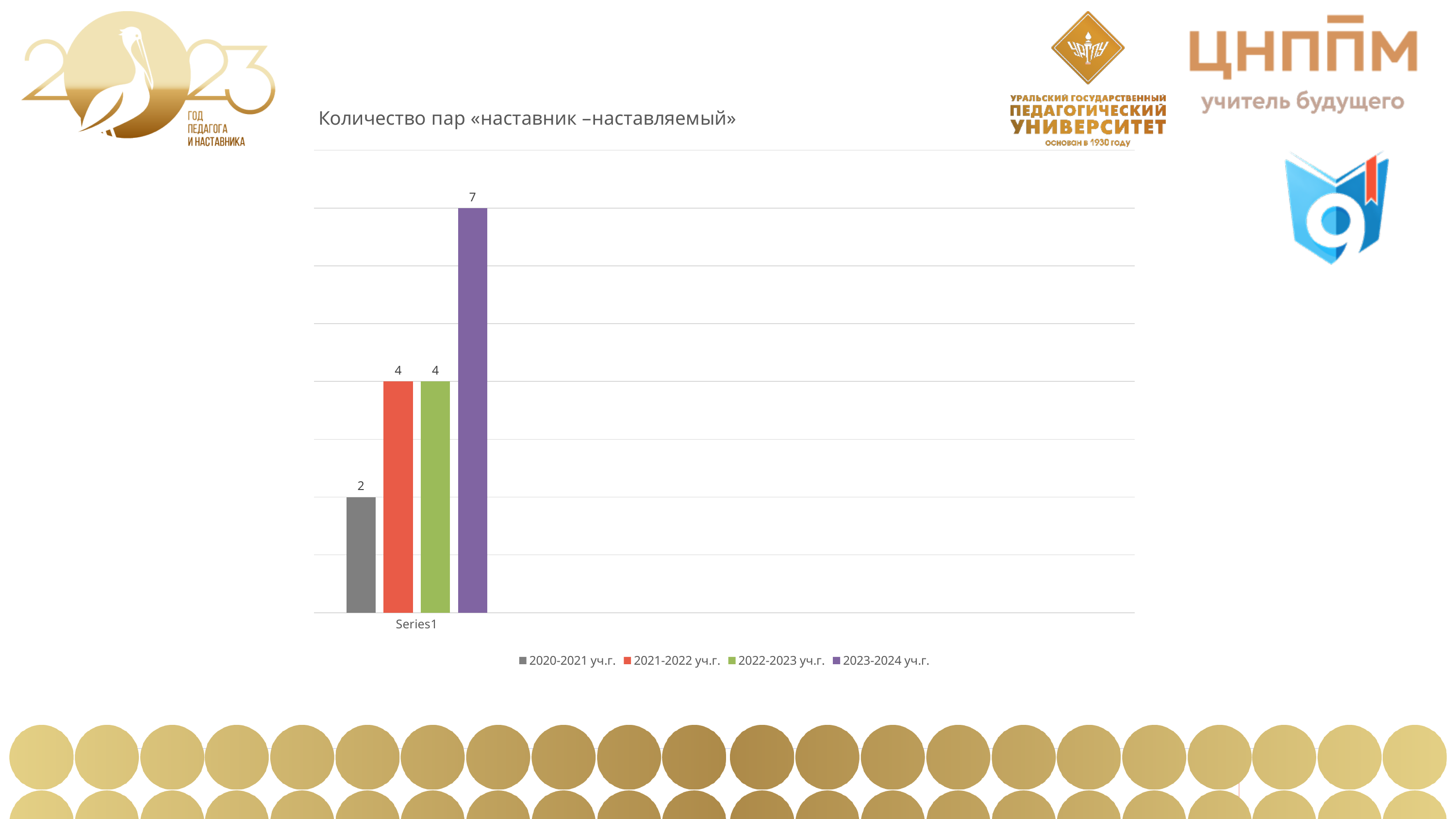
What is the value for 2021-2022 уч.г.? 4 What is the value for 2023-2024 уч.г.? 7 What is the difference between the values for 2023-2024 уч.г. and 2020-2021 уч.г.? 5 How many series does the legend list? 4 What is the value for 2020-2021 уч.г.? 2 What is the value for 2022-2023 уч.г.? 4 What is the difference between the values for 2023-2024 уч.г. and 2022-2023 уч.г.? 3 Which is larger, the value for 2021-2022 уч.г. or the value for 2023-2024 уч.г.? 2023-2024 уч.г. Which series has the lowest value? 2020-2021 уч.г. Which series has the highest value? 2023-2024 уч.г. What is the title of the chart? Количество пар «наставник –наставляемый» What kind of chart is shown on the slide? Bar chart